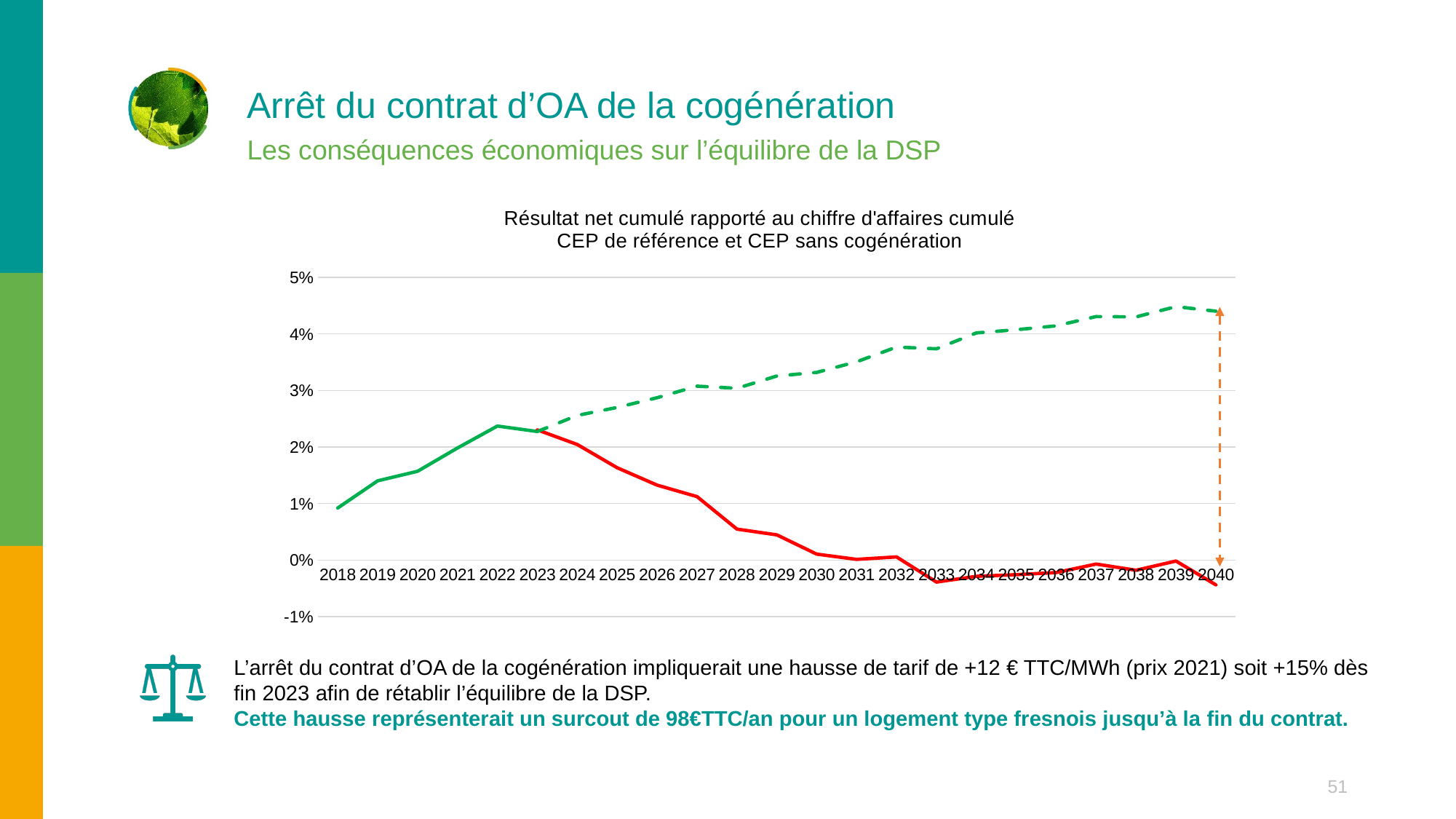
How many years are shown on the x axis of the chart? 23 Is the value of the red line in 2040 greater or less than 0%? less What kind of chart is shown on the slide? line chart Does the green dashed line rise or fall from 2023 to 2040? rise What is the title of the chart? Résultat net cumulé rapporté au chiffre d'affaires cumulé CEP de référence et CEP sans cogénération Is the value of the green dashed line in 2030 greater or less than 3%? greater Is the value of the red line in 2028 greater or less than 1%? less What is the first year shown on the x axis? 2018 Does the red line rise or fall from 2023 to 2033? fall In 2040, which line has the higher value, the green dashed line or the red line? the green dashed line What is the last year shown on the x axis? 2040